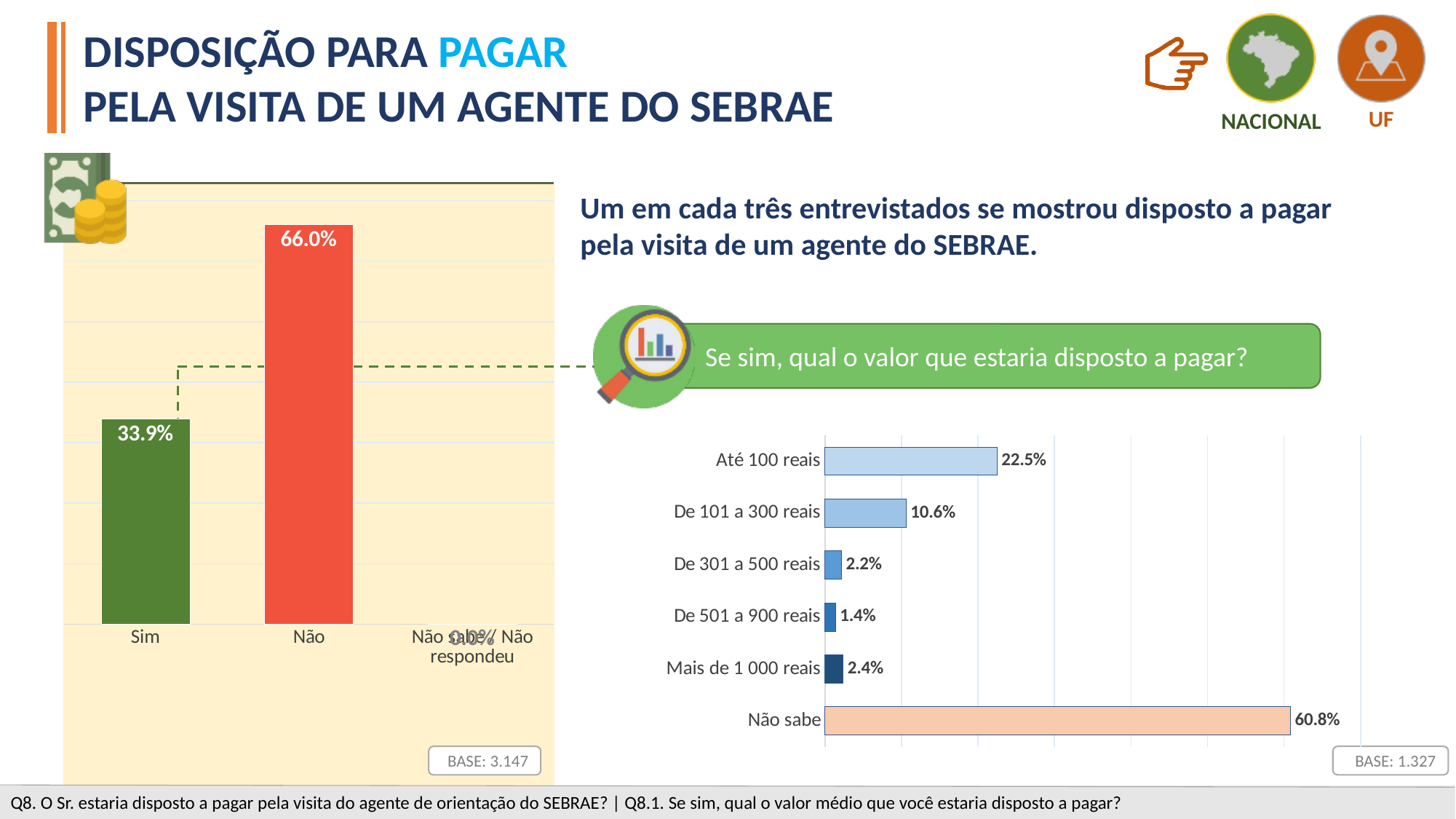
In the right chart, what is the value for "Não sabe"? 60.8% In the left chart, what percentage of respondents answered "Sim"? 33.9% In the right chart, what is the value for "Até 100 reais"? 22.5% In the right chart, what is the value for "De 101 a 300 reais"? 10.6% In the left chart, which category has the highest value? Não In the left chart, what is the difference between the "Não" and "Sim" values? 32.1% In the right chart, what is the difference between "Até 100 reais" and "De 101 a 300 reais"? 11.9% What kind of chart is the right chart? Bar chart In the right chart, which category has the lowest value? De 501 a 900 reais In the left chart, what percentage of respondents answered "Não"? 66.0% In the right chart, which is larger: "De 301 a 500 reais" or "Mais de 1 000 reais"? Mais de 1 000 reais In the left chart, how many categories are shown on the x axis? 3